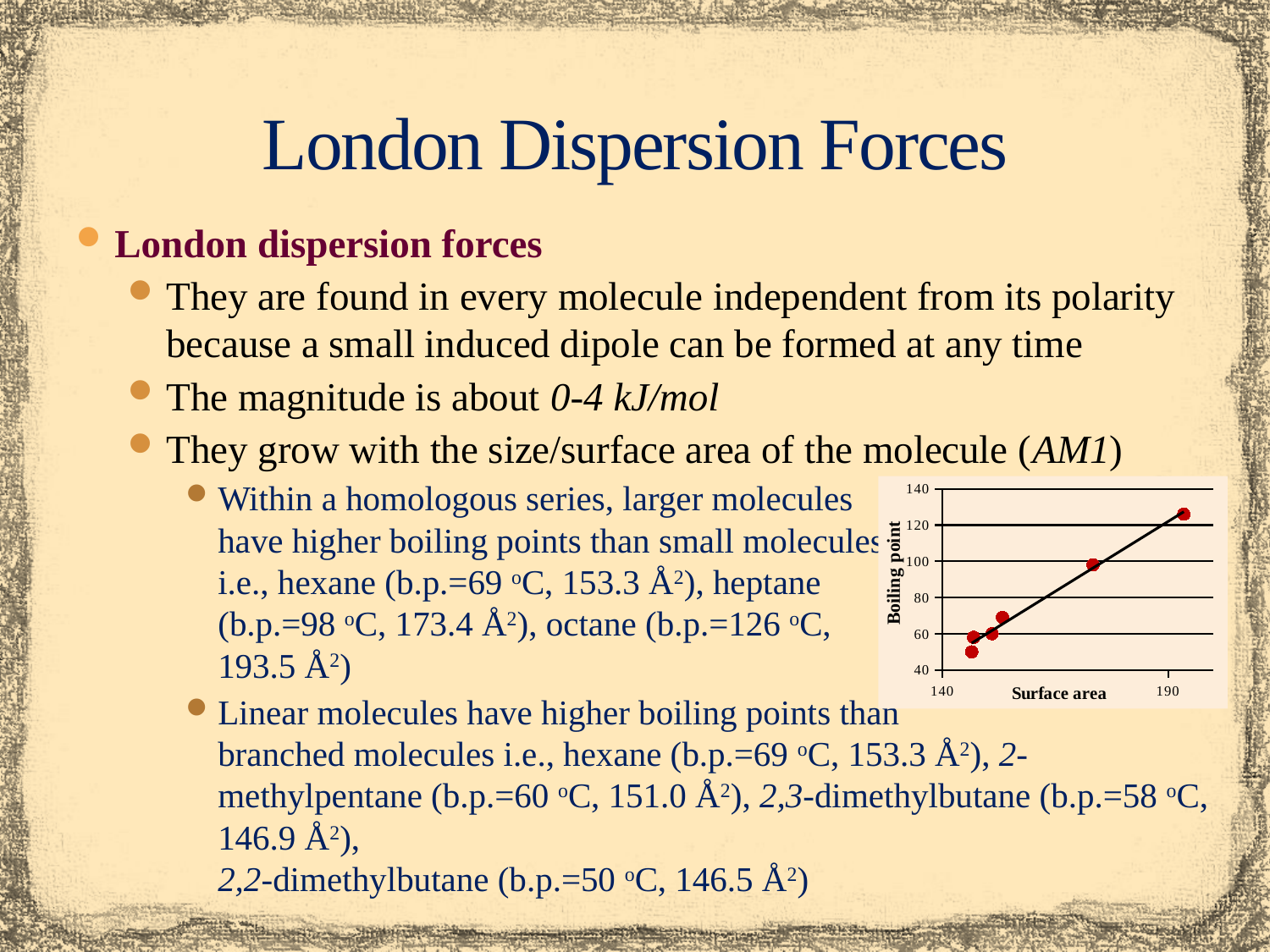
What is the label of the vertical axis of the chart? Boiling point What kind of chart is shown on the slide? scatter chart Do the boiling point values rise or fall as surface area increases along the x axis? rise Is the boiling point of the lowest plotted point greater or less than 40? greater Is the boiling point of the lowest plotted point greater or less than 60? less How many data points are plotted on the chart? 6 Is the boiling point of the point plotted near a surface area of 173 greater or less than 80? greater What is the label of the horizontal axis of the chart? Surface area